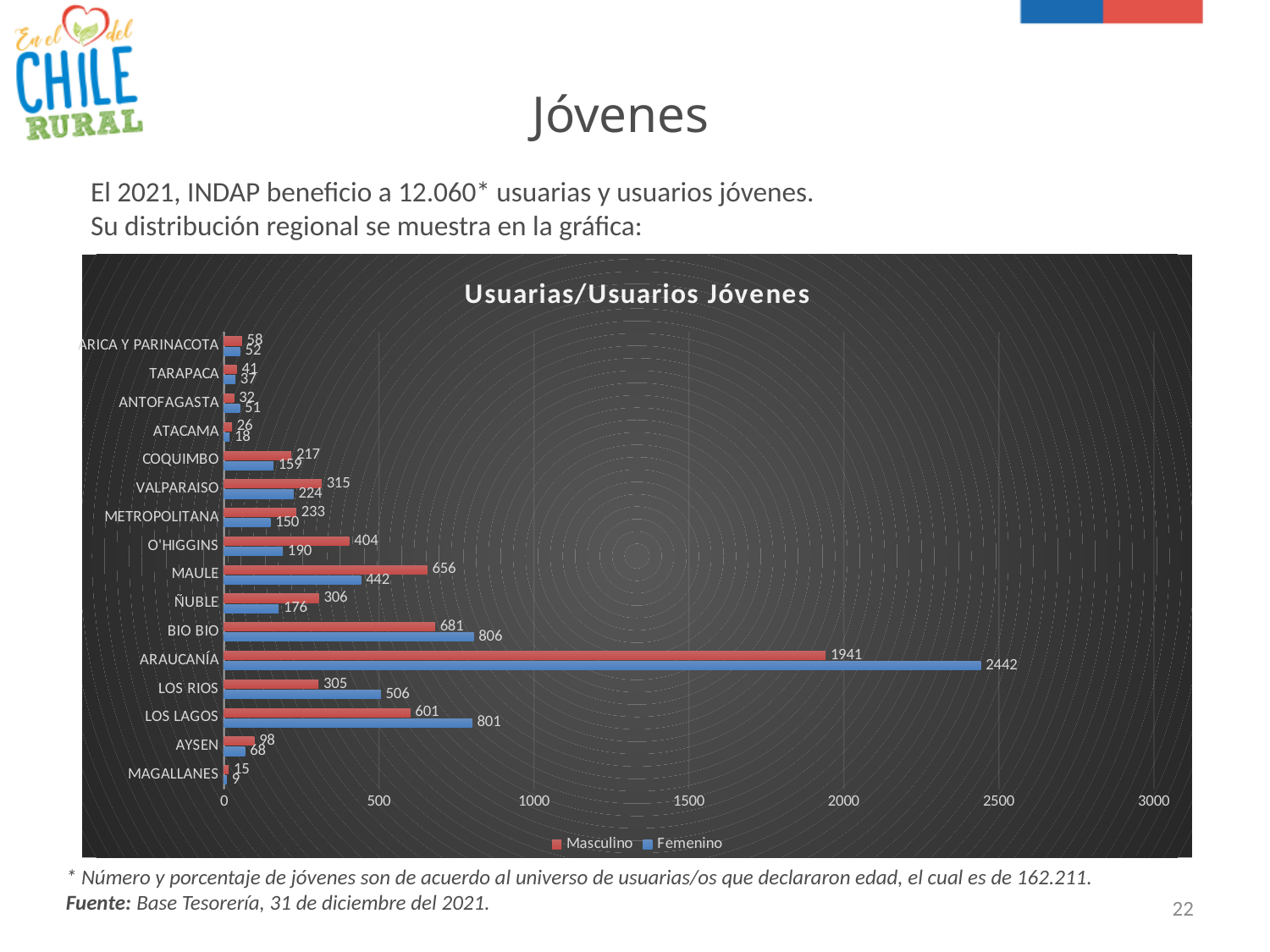
Which region has the highest Masculino value? Araucanía What is the Femenino value for Los Lagos? 801 What is the Masculino value for Maule? 656 Is the Masculino value for O'Higgins greater or less than 500? less What is the title of the chart? Usuarias/Usuarios Jóvenes What is the Femenino value for Araucanía? 2442 How many series does the legend list? 2 What is the difference between the Femenino and Masculino values for Araucanía? 501 Which region has the lowest Femenino value? Magallanes What kind of chart is shown on the slide? Bar chart How many regions are shown on the chart? 16 Which is larger for Bio Bio, the Masculino value or the Femenino value? Femenino